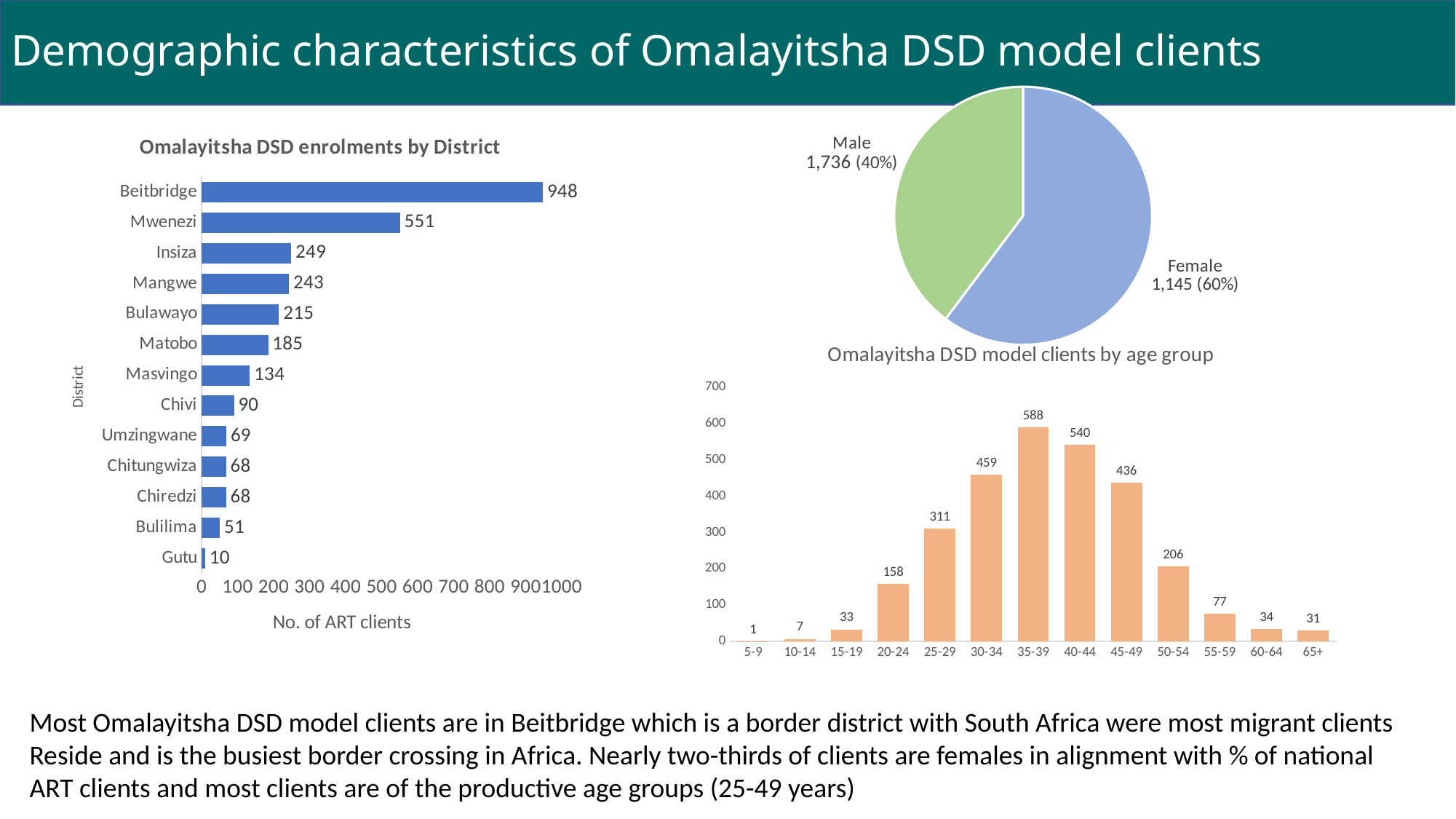
In the 'Omalayitsha DSD model clients by age group' chart, how many age groups are shown? 13 In the 'Omalayitsha DSD enrolments by District' chart, which is larger, Insiza or Mangwe? Insiza In the 'Omalayitsha DSD enrolments by District' chart, what is the difference between Beitbridge and Mwenezi? 397 In the 'Omalayitsha DSD enrolments by District' chart, which district has the lowest number of ART clients? Gutu In the pie chart, what percentage is shown for Female? 60% In the pie chart, what is the label shown for the Male slice? 1,736 (40%) In the 'Omalayitsha DSD model clients by age group' chart, which age group has the highest value? 35-39 In the 'Omalayitsha DSD enrolments by District' chart, what is the value for Beitbridge? 948 In the 'Omalayitsha DSD model clients by age group' chart, what is the difference between the 40-44 and 50-54 age groups? 334 In the 'Omalayitsha DSD enrolments by District' chart, how many districts are shown? 13 What kind of chart is 'Omalayitsha DSD enrolments by District'? Bar chart In the 'Omalayitsha DSD model clients by age group' chart, what is the value for the 45-49 age group? 436